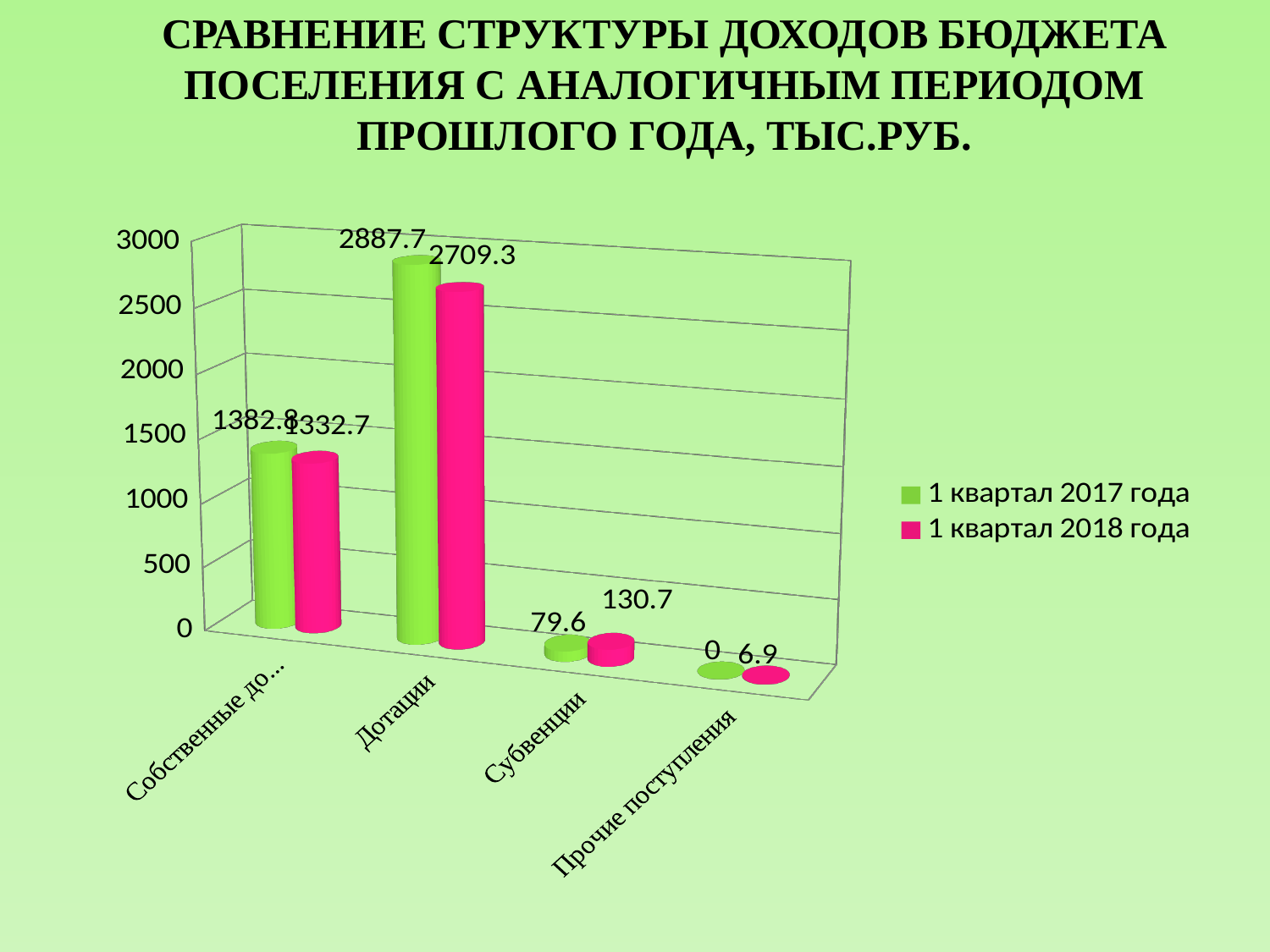
What is the value for Субвенции in 1 квартал 2018 года? 130.7 What type of chart is shown on the slide? bar chart How many series does the legend list? 2 What is the value for Дотации in 1 квартал 2017 года? 2887.7 What is the difference between the 1 квартал 2017 года and 1 квартал 2018 года values for Дотации? 178.4 What is the value for Прочие поступления in 1 квартал 2017 года? 0 Which category has the highest value in 1 квартал 2018 года? Дотации What is the value for Дотации in 1 квартал 2018 года? 2709.3 For Субвенции, which series has the larger value: 1 квартал 2017 года or 1 квартал 2018 года? 1 квартал 2018 года How many categories are shown on the x axis? 4 Which colour represents 1 квартал 2018 года in the legend? pink Which category has the lowest value in 1 квартал 2017 года? Прочие поступления